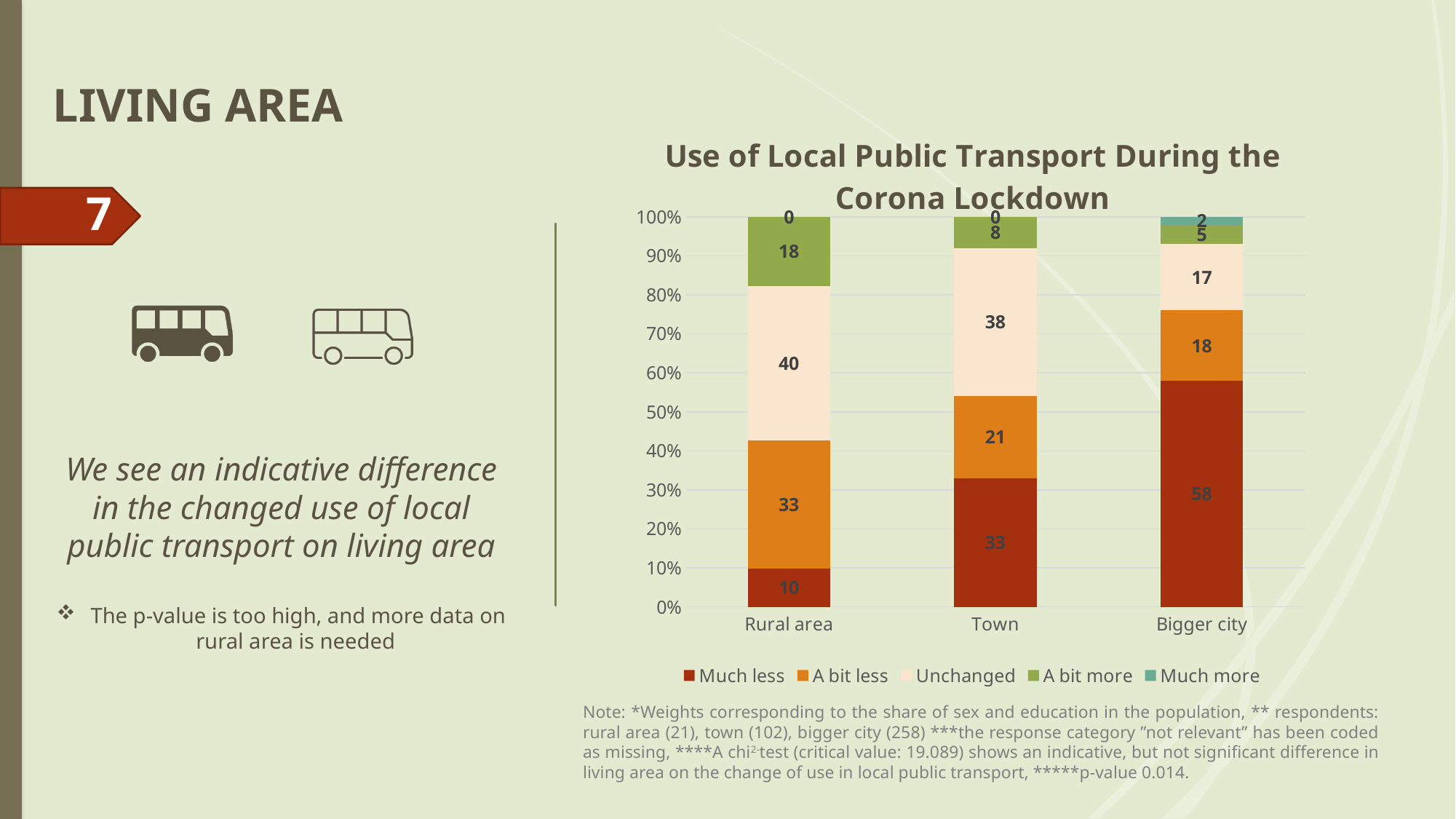
What is the value for "Much more" in the Bigger city bar? 2 What is the value for "Much less" in the Bigger city bar? 58 What is the value for "Unchanged" in the Rural area bar? 40 What kind of chart is shown on the slide? Stacked bar chart Which living area has the lowest value for "Unchanged"? Bigger city How many series does the legend list? 5 Which is larger: the "A bit more" value for Rural area or for Town? Rural area What is the value for "A bit less" in the Town bar? 21 What is the title of the chart? Use of Local Public Transport During the Corona Lockdown How many living area categories are shown on the x axis? 3 Which living area has the highest value for "Much less"? Bigger city What is the difference between the "Much less" values for Bigger city and Rural area? 48